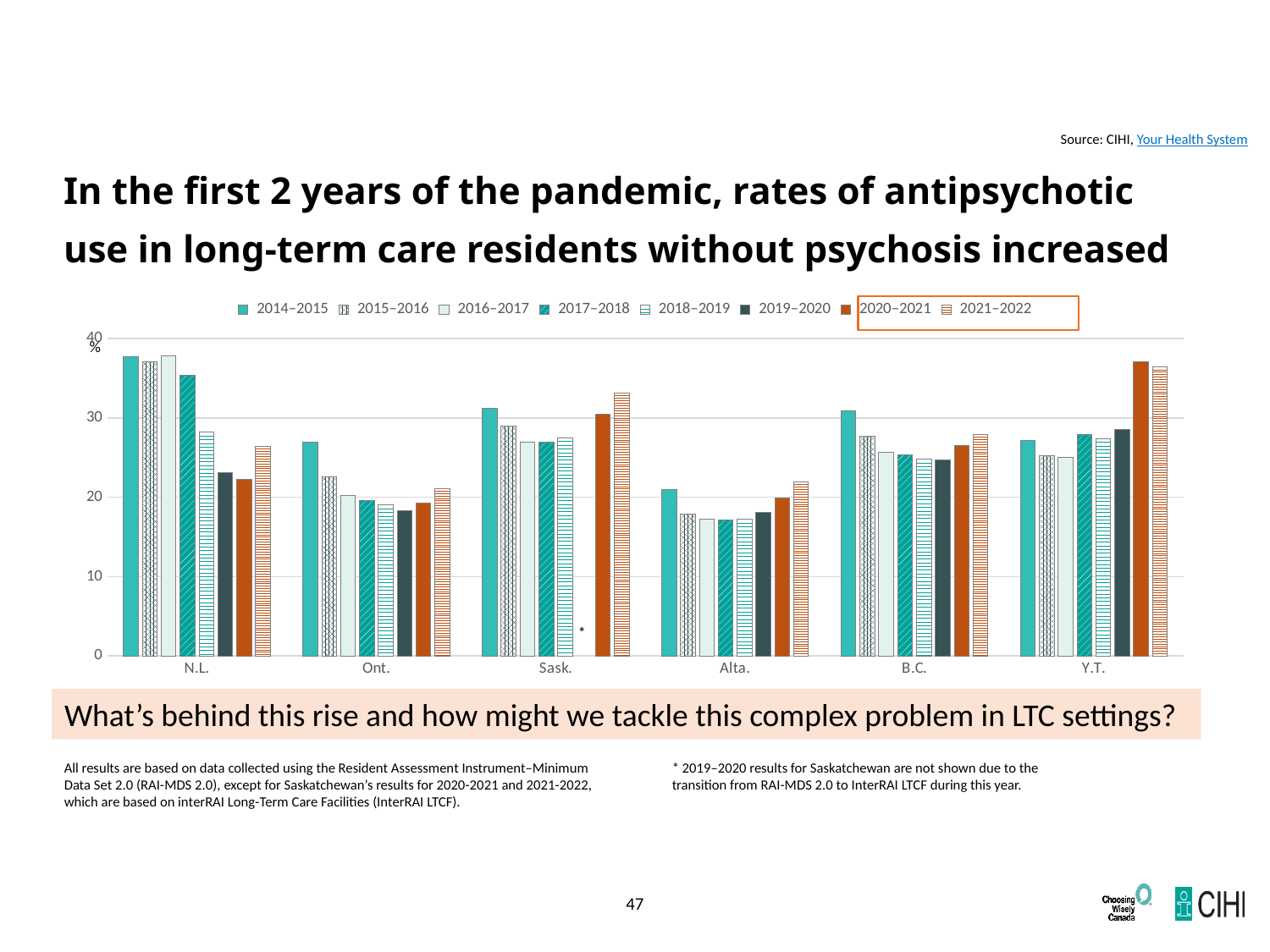
Which is larger for Y.T.: the 2014–2015 value or the 2020–2021 value? 2020–2021 Is the value for Sask. in 2021–2022 greater or less than 30? greater Which category has the highest value for the 2021–2022 series? Y.T. Which category has the highest value for the 2014–2015 series? N.L. Is the value for Y.T. in 2020–2021 greater or less than 30? greater How many provinces/territories (categories) are shown on the x axis? 6 How many series (fiscal years) does the legend list? 8 Is the value for Alta. in 2017–2018 greater or less than 20? less Which is larger for N.L.: the 2014–2015 value or the 2021–2022 value? 2014–2015 What kind of chart is shown on the slide? bar chart